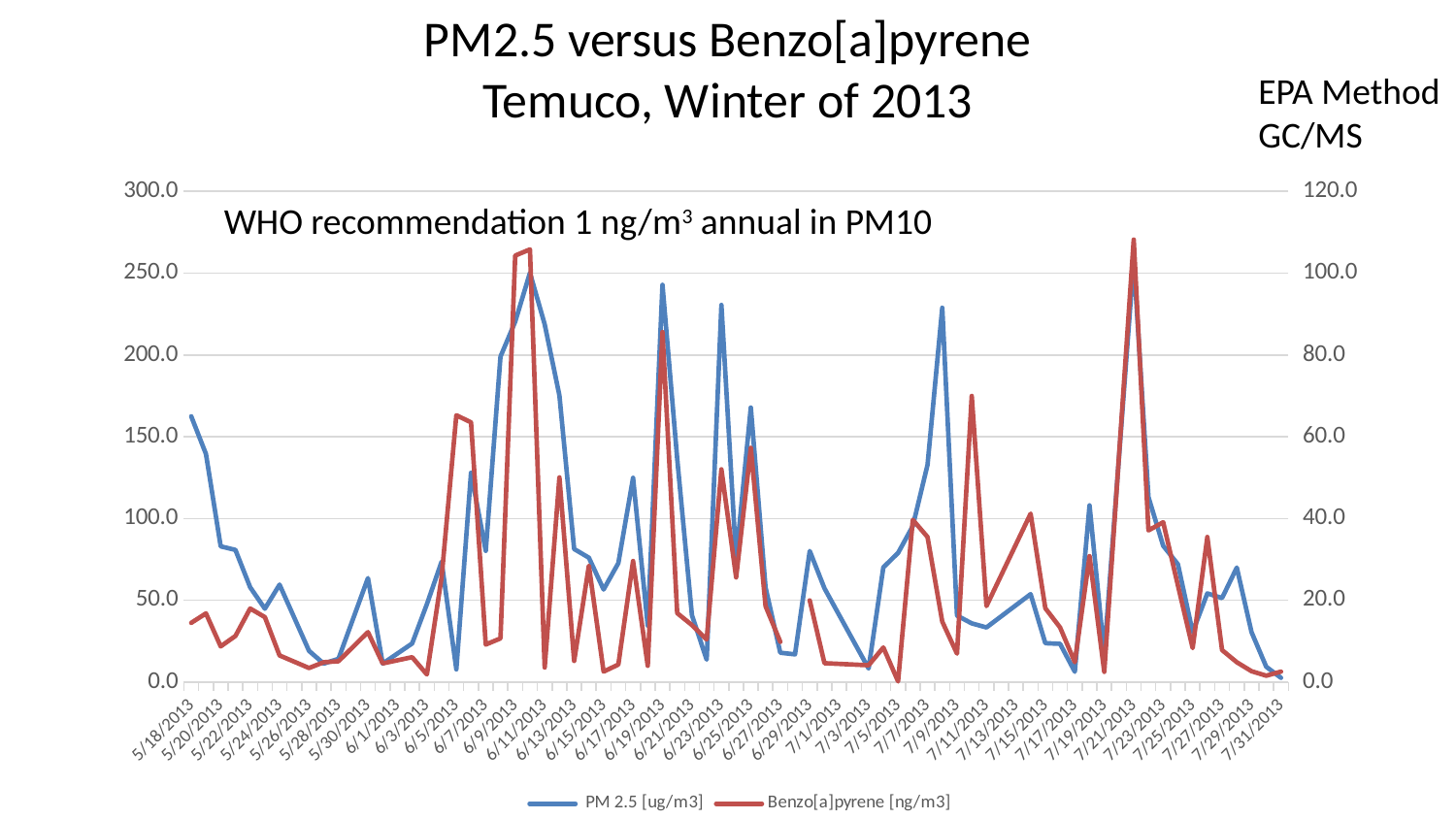
Is the PM 2.5 value on 7/31/2013 greater or less than 50.0? less Which is larger on 6/19/2013: the PM 2.5 value on the left axis or the Benzo[a]pyrene value on the right axis? PM 2.5 What is the title of the chart? PM2.5 versus Benzo[a]pyrene Temuco, Winter of 2013 What are the two series named in the legend? PM 2.5 [ug/m3] and Benzo[a]pyrene [ng/m3] Does the PM 2.5 series rise or fall between 5/18/2013 and 5/28/2013? fall Is the PM 2.5 value on 6/11/2013 greater or less than 200.0? greater Does the Benzo[a]pyrene series rise or fall between 7/21/2013 and 7/31/2013? fall Is the Benzo[a]pyrene value on 5/28/2013 greater or less than 20.0 on the right axis? less What kind of chart is shown on the slide? line chart How many series does the legend list? 2